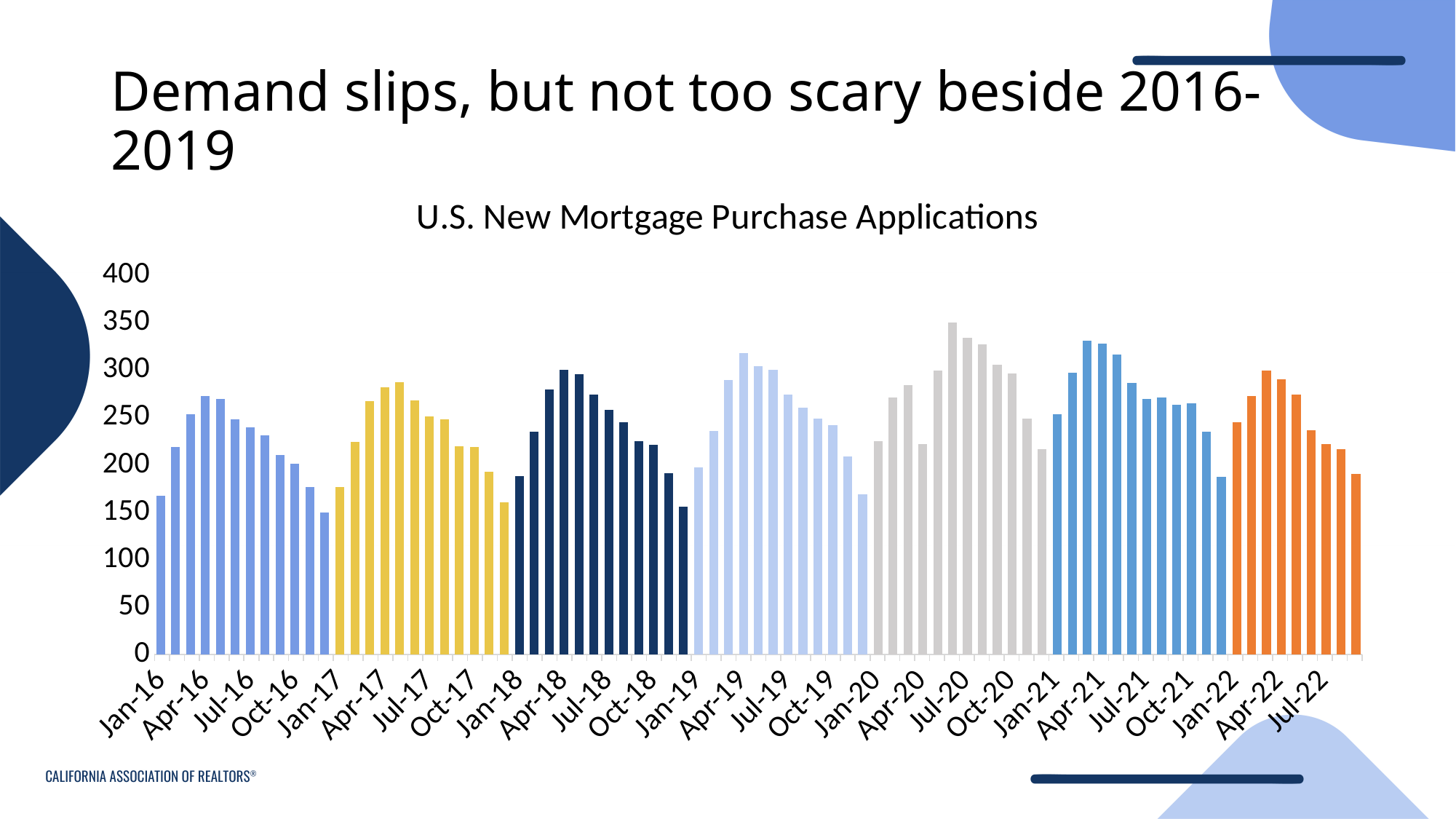
Is the value for Jul-20 greater or less than 300? greater Is the value for Jan-20 greater or less than 200? greater What is the highest value shown on the vertical axis? 400 What kind of chart is shown on the slide? bar chart Which month has the highest value in the chart? Jun-20 What is the title of the chart? U.S. New Mortgage Purchase Applications Is the value for Jan-16 greater or less than 150? greater Do the values rise or fall from Jan-16 to Apr-16? rise Which is larger, the value for Apr-21 or the value for Apr-22? Apr-21 Which is larger, the value for Jul-20 or the value for Jul-19? Jul-20